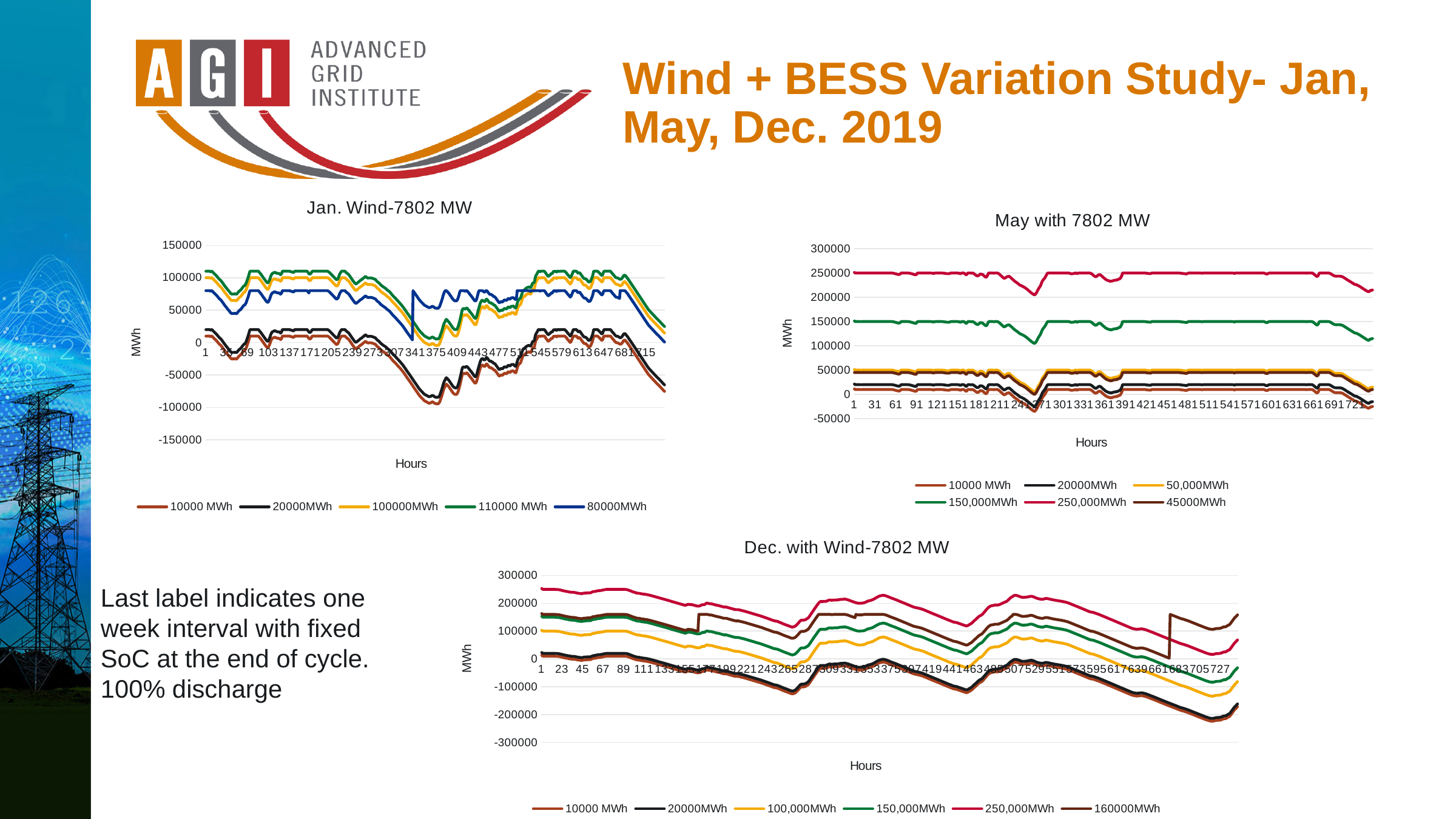
What is the y-axis label of the 'Dec. with Wind-7802 MW' chart? MWh What is the highest value shown on the y-axis of the 'Jan. Wind-7802 MW' chart? 150000 In the 'Dec. with Wind-7802 MW' chart, is the value of the 10000 MWh series at hour 1 greater or less than 100000? less In the 'May with 7802 MW' chart, is the value of the 250,000MWh series at hour 1 greater or less than 150000? greater In the 'Dec. with Wind-7802 MW' chart, is the value of the 250,000MWh series at hour 1 greater or less than 200000? greater What kind of chart is the 'Jan. Wind-7802 MW' chart? line chart How many series does the legend of the 'Jan. Wind-7802 MW' chart list? 5 How many series does the legend of the 'Dec. with Wind-7802 MW' chart list? 6 In the 'Jan. Wind-7802 MW' chart, which series is higher at hour 1: 110000 MWh or 10000 MWh? 110000 MWh How many series does the legend of the 'May with 7802 MW' chart list? 6 In the 'May with 7802 MW' chart, which series is higher at hour 1: 250,000MWh or 150,000MWh? 250,000MWh